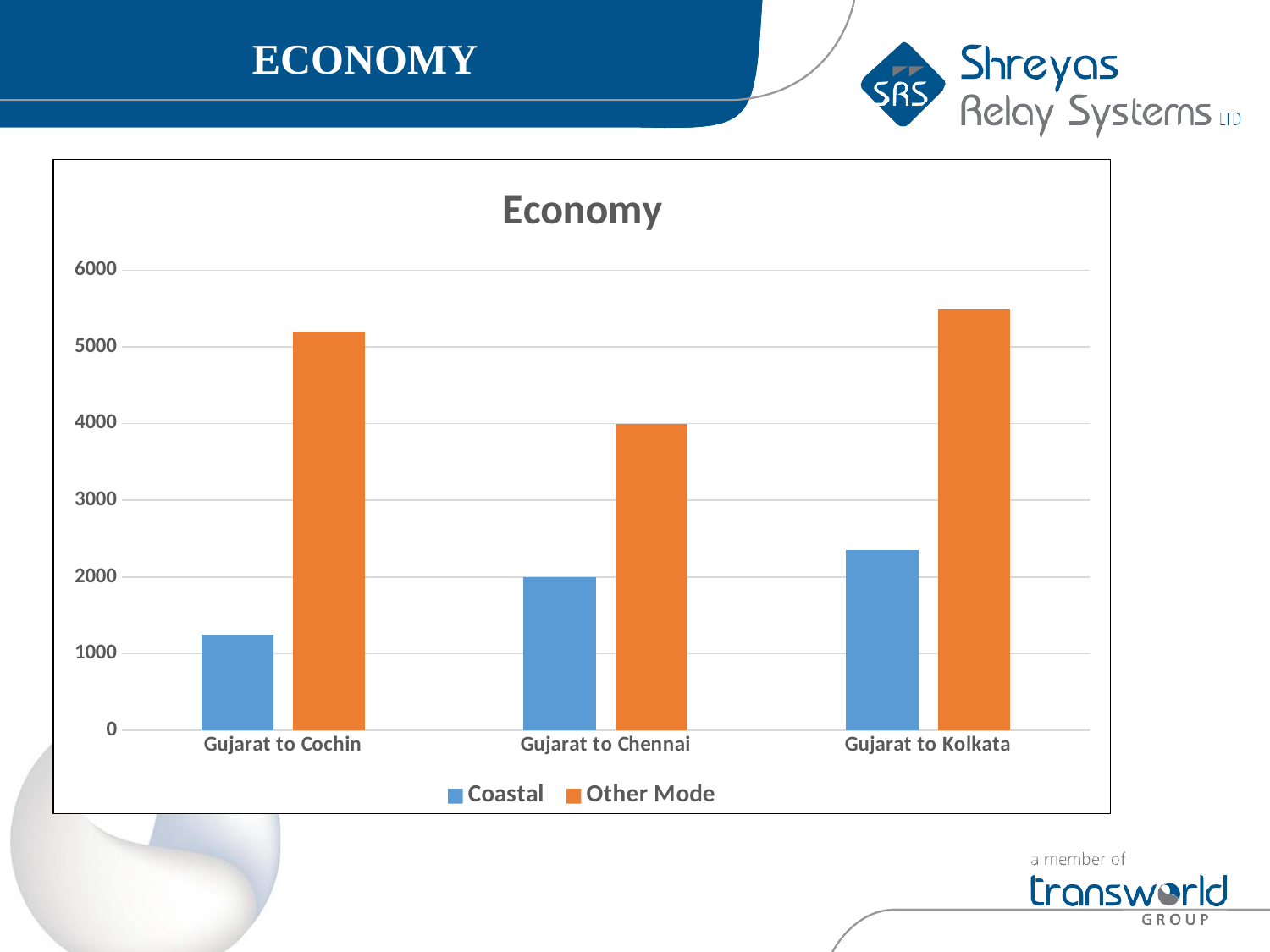
Is the Other Mode value for Gujarat to Kolkata greater or less than 5000? greater Is the Coastal value for Gujarat to Cochin greater or less than 2000? less What is the Coastal value for Gujarat to Chennai? 2000 What is the title of the chart? Economy For Gujarat to Cochin, which is larger: Coastal or Other Mode? Other Mode How many route categories are shown on the x axis? 3 What kind of chart is shown on the slide? bar chart Which route has the lowest Other Mode value? Gujarat to Chennai How many series does the legend list? 2 Which route has the highest Other Mode value? Gujarat to Kolkata Which route has the lowest Coastal value? Gujarat to Cochin What is the Other Mode value for Gujarat to Chennai? 4000